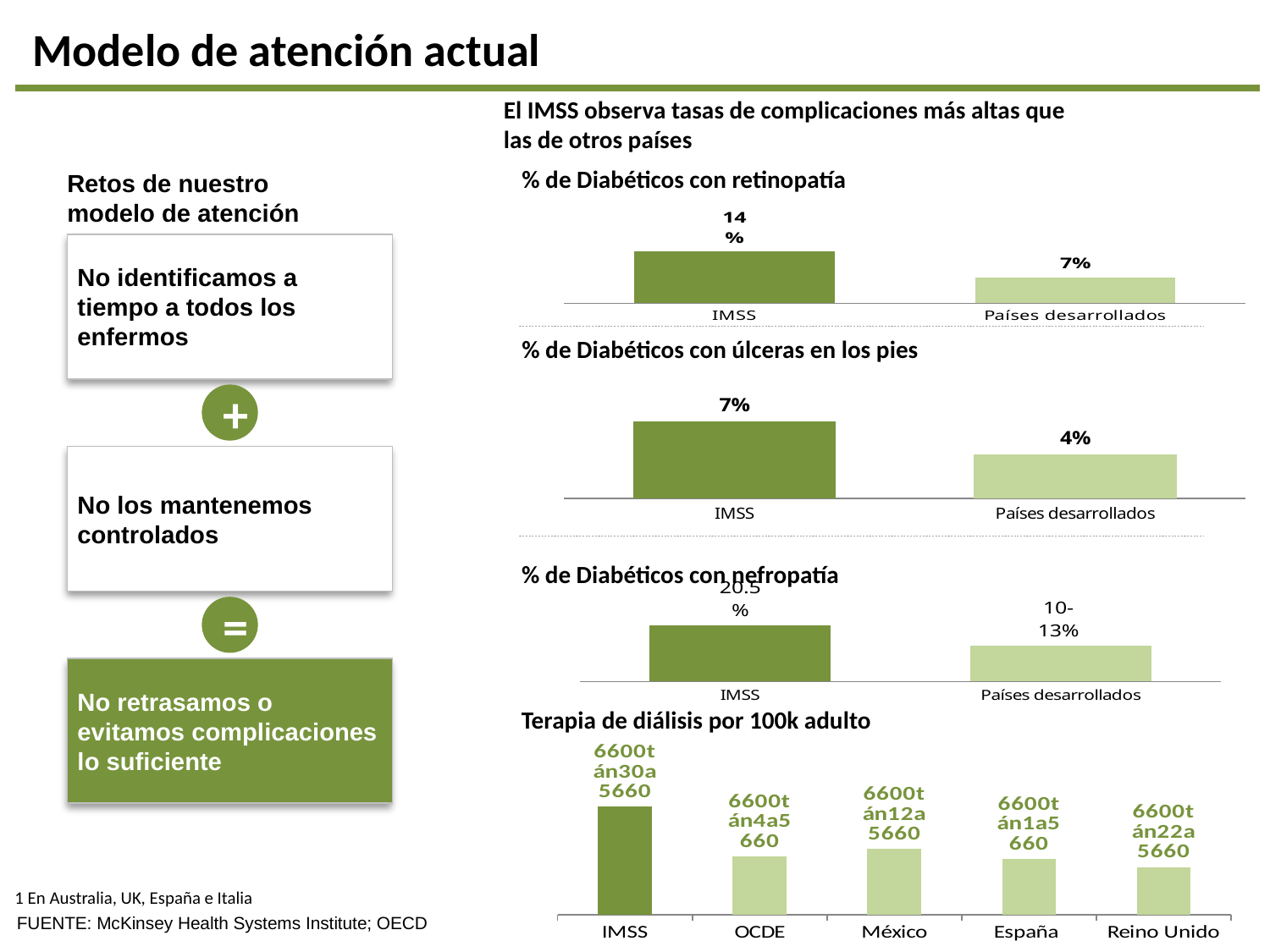
In the chart '% de Diabéticos con nefropatía', what is the value shown for Países desarrollados? 10-13% In the chart 'Terapia de diálisis por 100k adulto', how many categories are shown on the x axis? 5 In the chart 'Terapia de diálisis por 100k adulto', which category has the highest bar? IMSS In the chart '% de Diabéticos con retinopatía', what is the difference between IMSS and Países desarrollados? 7% In the chart '% de Diabéticos con úlceras en los pies', what is the value for Países desarrollados? 4% In the chart 'Terapia de diálisis por 100k adulto', which is larger, IMSS or OCDE? IMSS In the chart '% de Diabéticos con úlceras en los pies', which category has the higher value? IMSS In the chart '% de Diabéticos con nefropatía', what is the value for IMSS? 20.5% What type of chart is '% de Diabéticos con retinopatía'? Bar chart In the chart '% de Diabéticos con retinopatía', what is the value for IMSS? 14% In the chart '% de Diabéticos con úlceras en los pies', what is the value for IMSS? 7% In the chart '% de Diabéticos con retinopatía', what is the value for Países desarrollados? 7%